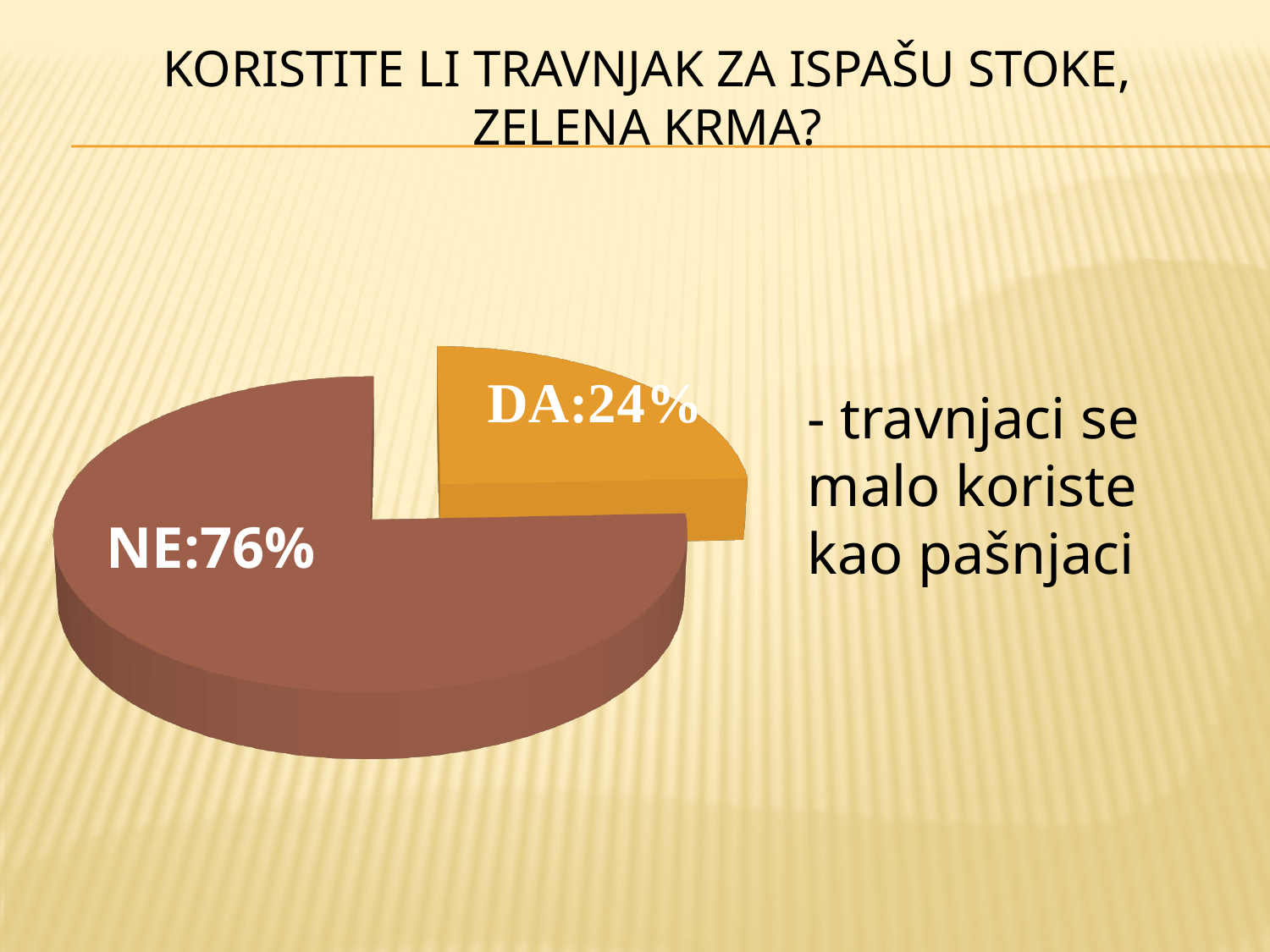
Which is larger, the DA slice or the NE slice? NE Which slice is the largest in the pie chart? NE Is the value for NE greater or less than 50%? greater Which slice is the smallest in the pie chart? DA What colour is the DA slice of the pie chart? orange What is the difference in percentage points between the NE and DA slices? 52 Is the value for DA greater or less than 50%? less What share of the pie does the NE slice represent? 76% What share of the pie does the DA slice represent? 24% What is the title of the slide containing the pie chart? KORISTITE LI TRAVNJAK ZA ISPAŠU STOKE, ZELENA KRMA? How many slices does the pie chart have? 2 What kind of chart is shown on the slide? pie chart